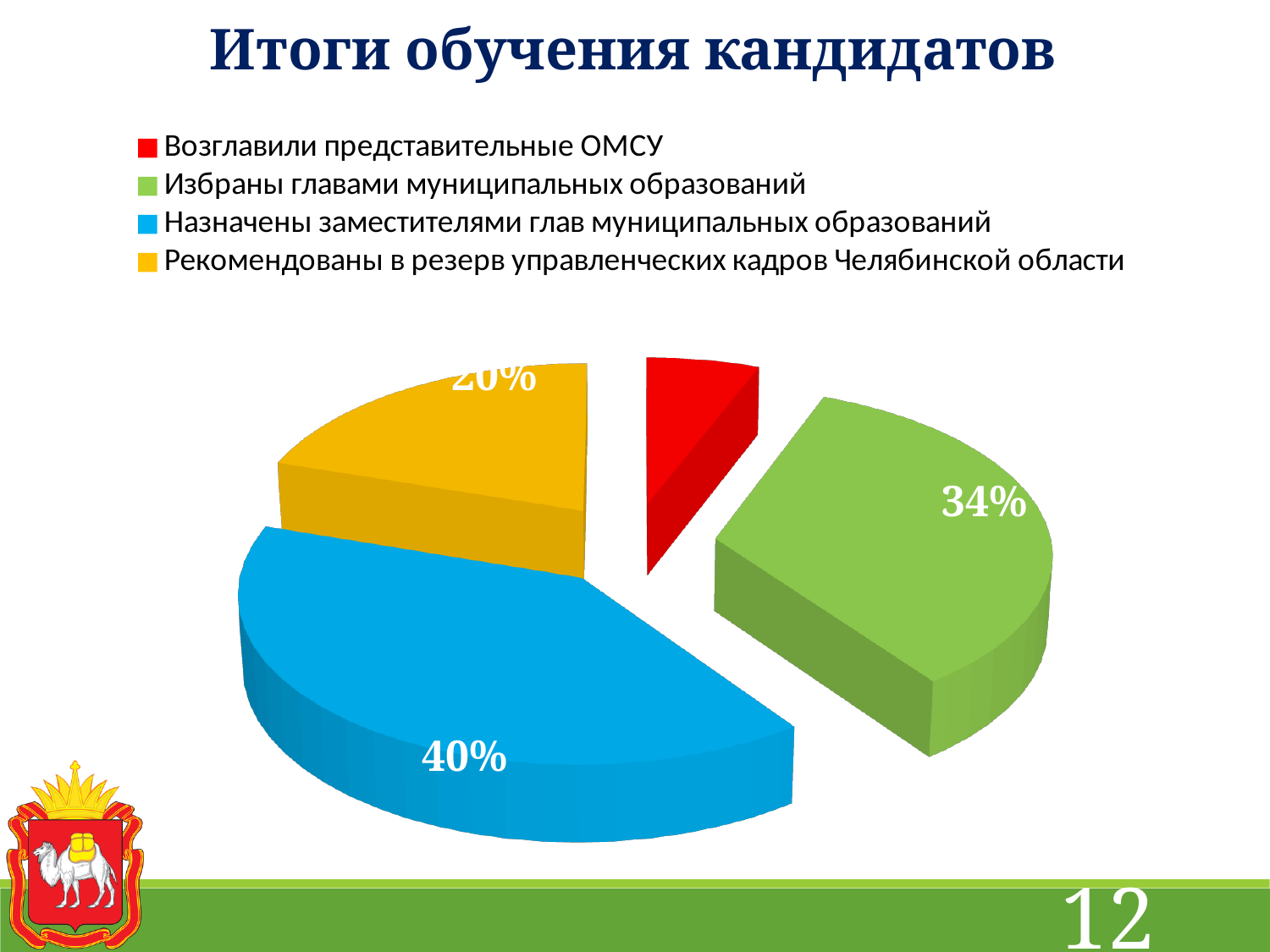
Which category has the largest slice of the pie? Назначены заместителями глав муниципальных образований What type of chart is shown on the slide? Pie chart What share of the pie is labelled for 'Рекомендованы в резерв управленческих кадров Челябинской области'? 20% Which category has the smallest slice of the pie? Возглавили представительные ОМСУ What colour is the slice for 'Возглавили представительные ОМСУ'? Red What share of the pie is labelled for 'Избраны главами муниципальных образований'? 34% Which is larger: the share for 'Избраны главами муниципальных образований' or the share for 'Рекомендованы в резерв управленческих кадров Челябинской области'? Избраны главами муниципальных образований What share of the pie is labelled for 'Назначены заместителями глав муниципальных образований'? 40% How many categories does the legend of the pie chart list? 4 What is the difference between the shares for 'Назначены заместителями глав муниципальных образований' and 'Избраны главами муниципальных образований'? 6% What is the title of the chart on the slide? Итоги обучения кандидатов What is the combined share of the slices labelled 40% and 20%? 60%